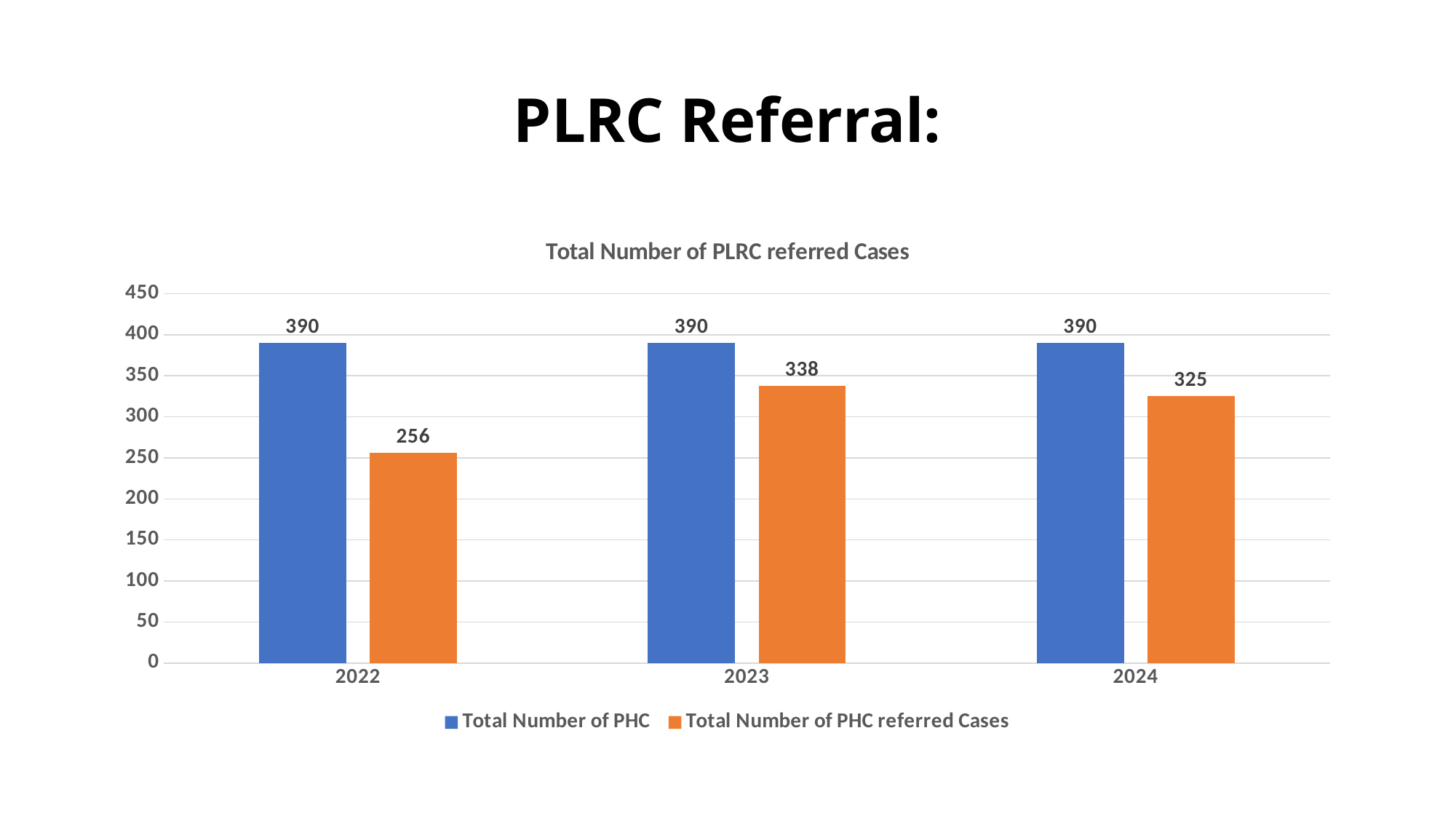
What is the difference between the Total Number of PHC referred Cases in 2023 and in 2024? 13 In which year is the Total Number of PHC referred Cases lowest? 2022 What is the Total Number of PHC referred Cases in 2022? 256 What is the Total Number of PHC in 2023? 390 How many series does the chart legend list? 2 What is the Total Number of PHC referred Cases in 2023? 338 What is the Total Number of PHC referred Cases in 2024? 325 What type of chart is shown on the slide? Bar chart What is the difference between the Total Number of PHC and the Total Number of PHC referred Cases in 2022? 134 How many years are shown on the x axis of the chart? 3 Which is larger: the Total Number of PHC referred Cases in 2023 or in 2024? 2023 In which year is the Total Number of PHC referred Cases highest? 2023